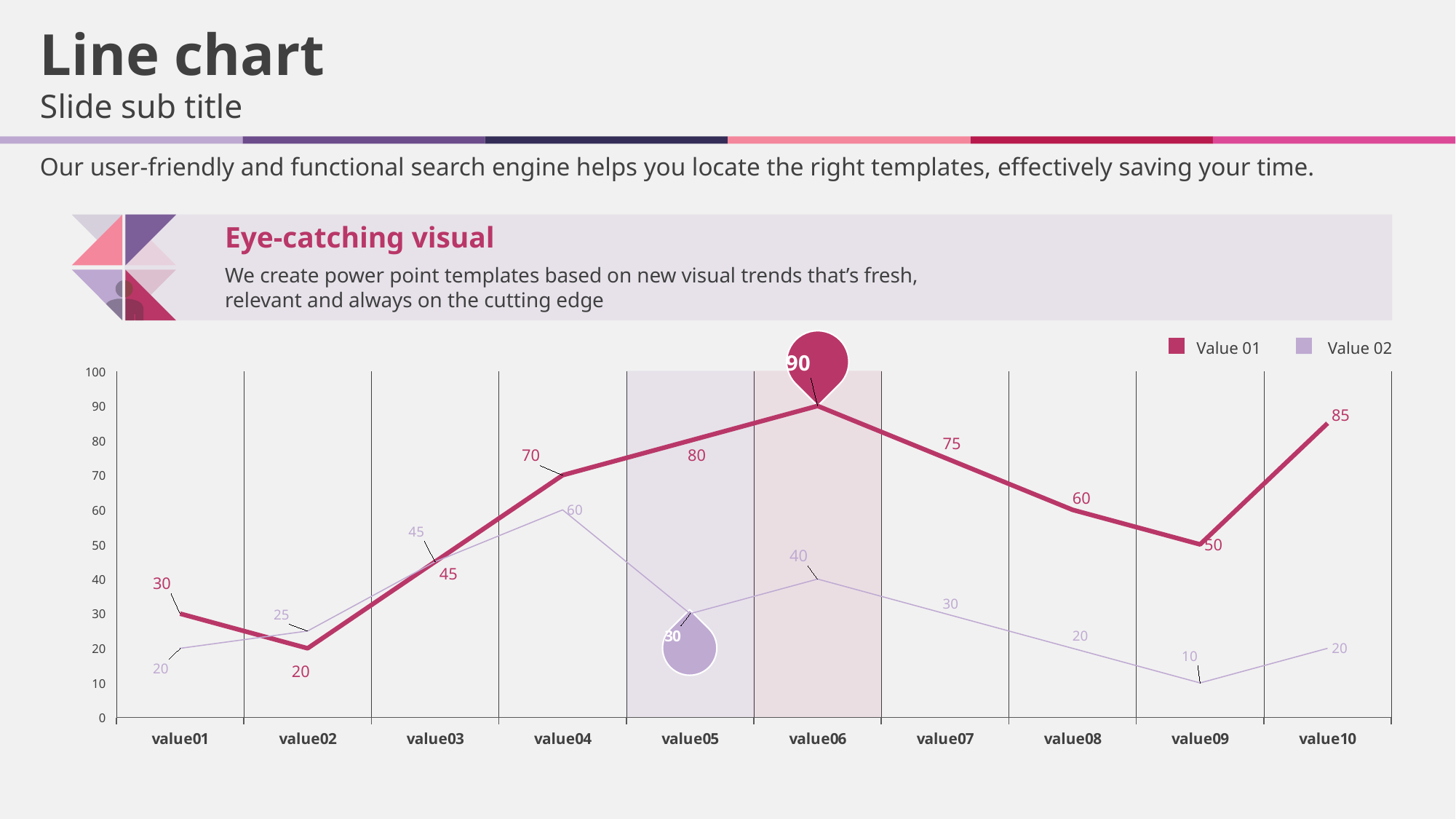
Does Value 01 rise or fall from value06 to value09? fall What is the value of Value 01 at value10? 85 How many categories are plotted along the x axis? 10 What is the difference between Value 01 and Value 02 at value06? 50 What kind of chart is shown on the slide? line chart At which category does Value 02 reach its lowest value? value09 At which category does Value 01 reach its highest value? value06 What are the two series names shown in the legend? Value 01 and Value 02 How many series does the legend list? 2 What is the value of Value 01 at value06? 90 What is the value of Value 02 at value04? 60 Which series has the larger value at value02? Value 02